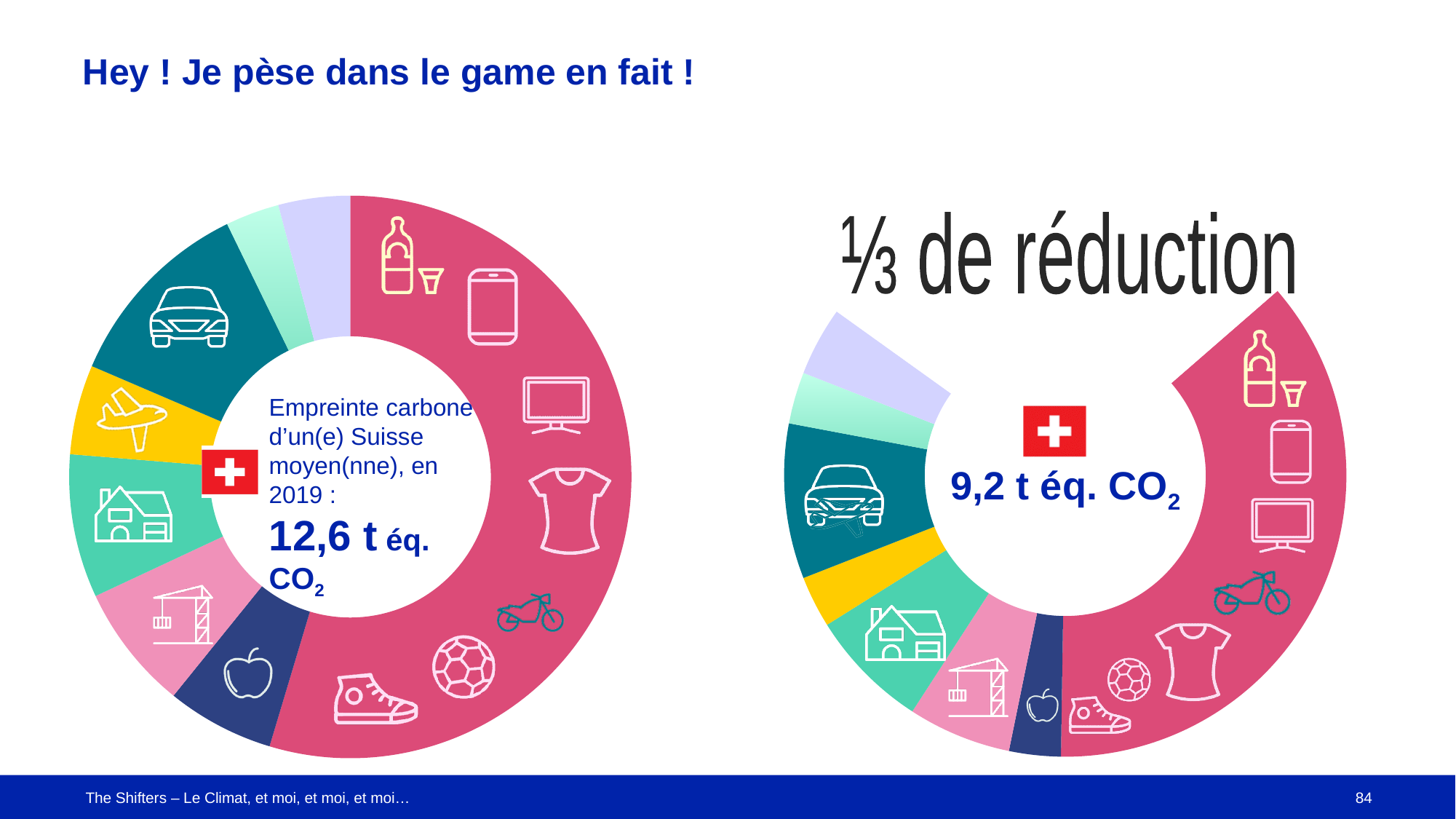
In the right chart, which colour slice is the largest? the pink/red slice What kind of chart is shown on the left of the slide? pie chart (donut) How many slices does the left donut chart have? 8 In the left chart, which colour slice is the largest? the pink/red slice What reduction is announced in the heading above the right chart? ⅓ de réduction Which chart shows the larger centre value, the left chart or the right chart? the left chart In the left chart, what is the carbon footprint of an average Swiss person in 2019 shown in the centre? 12,6 t éq. CO2 What is the difference between the centre value of the left chart (12,6 t éq. CO2) and the centre value of the right chart (9,2 t éq. CO2)? 3,4 t éq. CO2 How many slices does the right donut chart have? 8 What kind of chart is shown on the right of the slide? pie chart (donut) In the right chart, what value is shown in the centre of the donut? 9,2 t éq. CO2 In the left chart, which slice is larger, the pink slice with the phone and t-shirt icons or the dark teal slice with the car icon? the pink slice